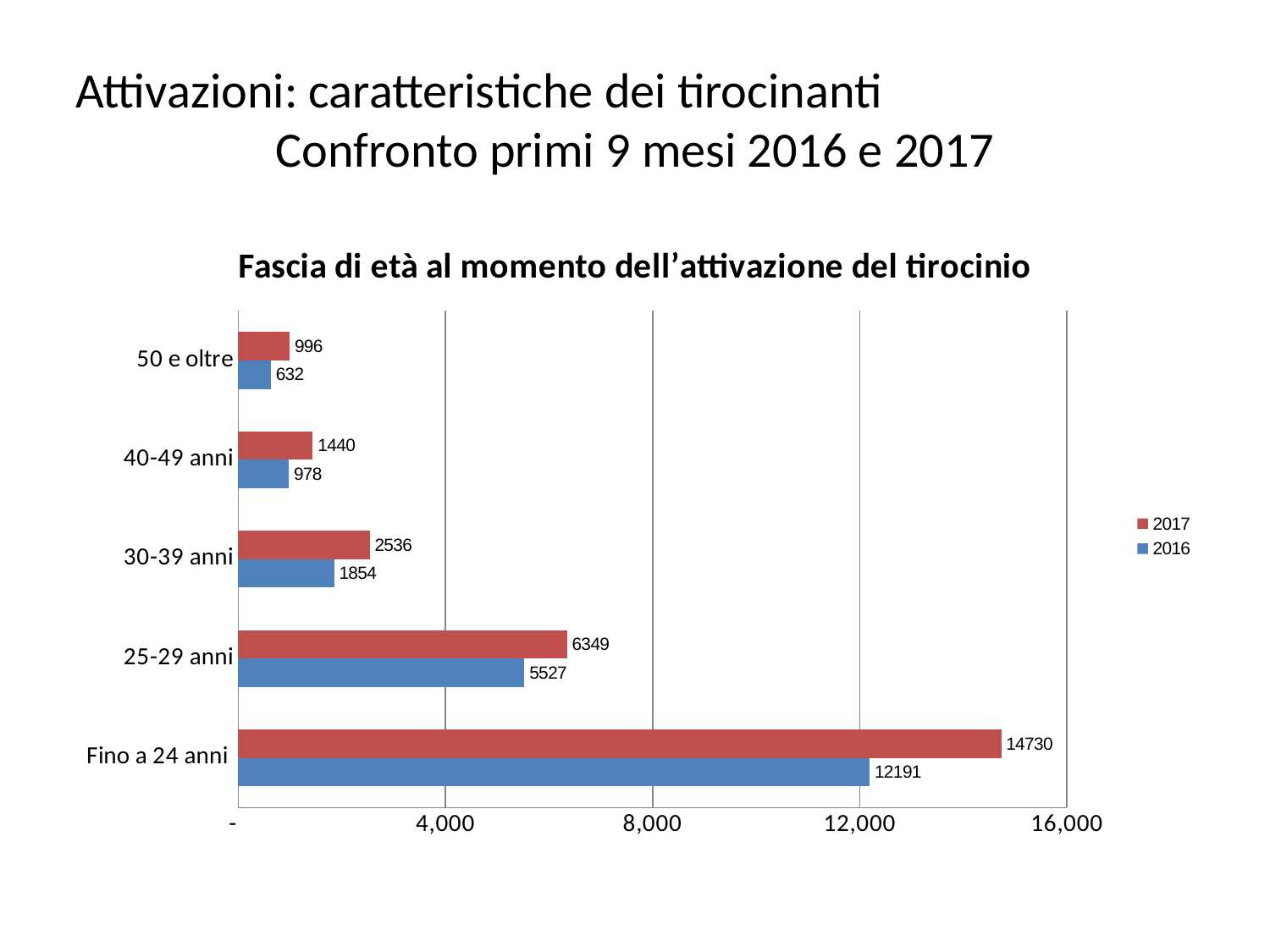
Which is larger: the 2016 value for '25-29 anni' or the 2017 value for '30-39 anni'? 2016 value for 25-29 anni How many series does the legend list? 2 What is the difference between the 2017 and 2016 values for 'Fino a 24 anni'? 2539 Which age category has the lowest value for 2017? 50 e oltre What is the value for 2017 in the '40-49 anni' category? 1440 What is the value for 2017 in the 'Fino a 24 anni' category? 14730 How many age categories are shown on the chart? 5 What is the value for 2016 in the '30-39 anni' category? 1854 What kind of chart is shown on the slide? Bar chart Which age category has the highest value for 2016? Fino a 24 anni What is the difference between the 2017 and 2016 values for '25-29 anni'? 822 Is the 2016 value for 'Fino a 24 anni' greater or less than 12,000? greater